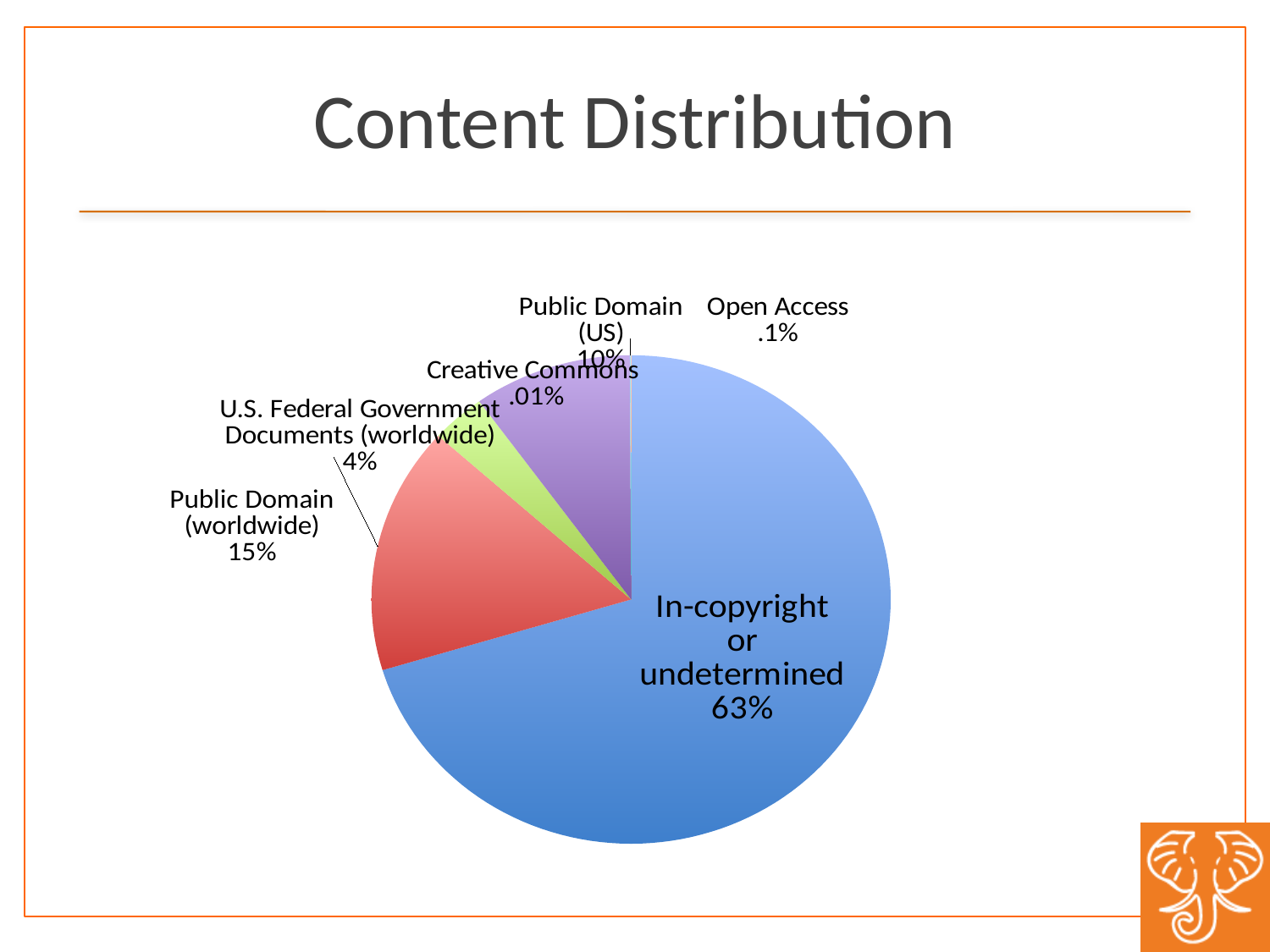
Which category has the smallest slice of the pie? Creative Commons What is the title of the chart? Content Distribution What share of the pie is Open Access? .1% What share of the pie is Public Domain (worldwide)? 15% Which category has the largest slice of the pie? In-copyright or undetermined What kind of chart is shown on the slide? pie chart What share of the pie is In-copyright or undetermined? 63% How many categories are shown in the pie chart? 6 What is the difference between the In-copyright or undetermined share and the Public Domain (worldwide) share? 48% Which is larger, the Public Domain (worldwide) slice or the U.S. Federal Government Documents (worldwide) slice? Public Domain (worldwide) What share of the pie is Creative Commons? .01% What share of the pie is U.S. Federal Government Documents (worldwide)? 4%